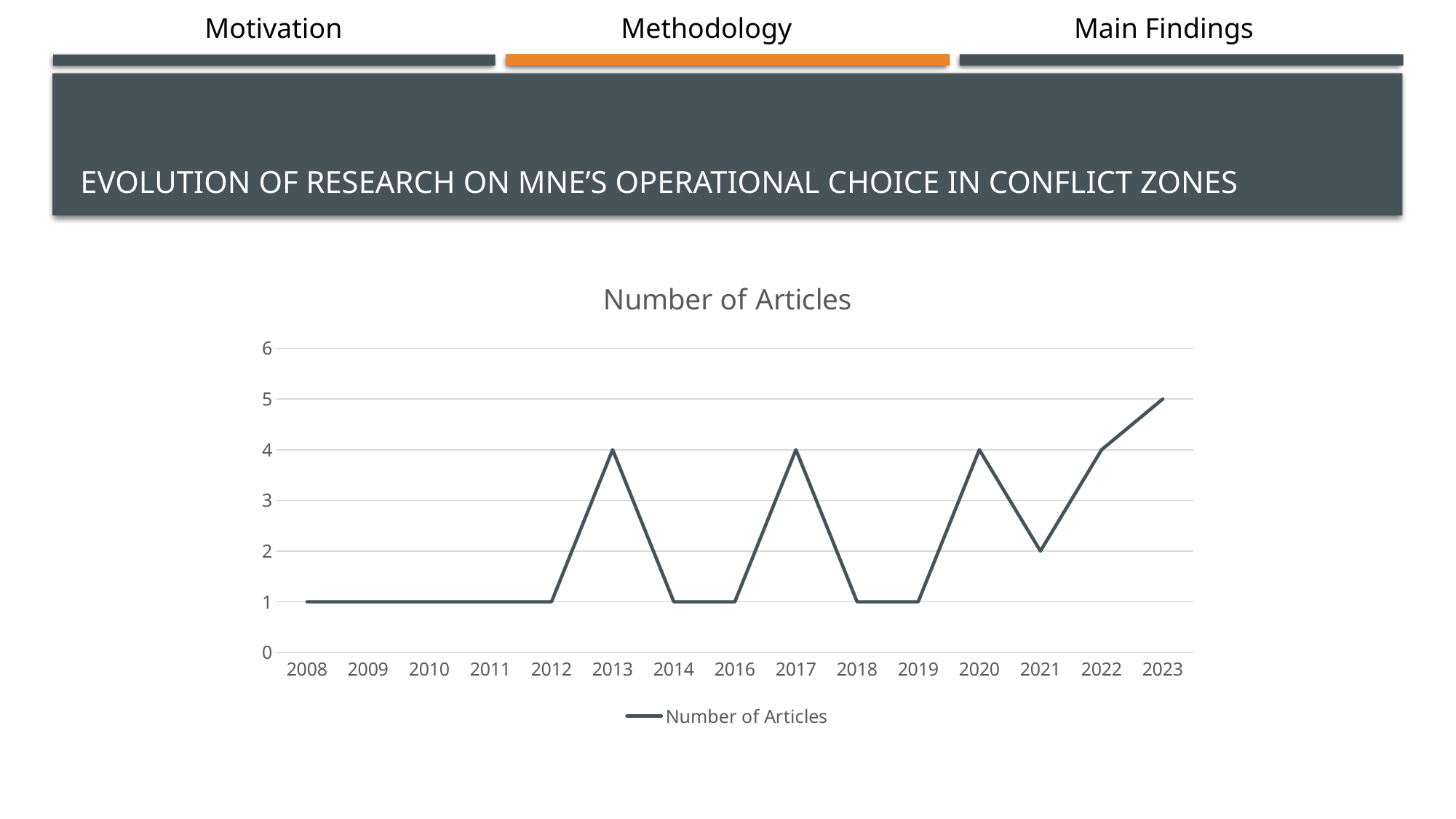
What type of chart is shown on the slide? line chart What is the number of articles in 2008? 1 Does the number of articles rise or fall from 2021 to 2023? rise What is the number of articles in 2013? 4 How many series does the legend list? 1 What is the difference in the number of articles between 2023 and 2021? 3 How many years are shown on the x axis? 15 What is the number of articles in 2023? 5 Which year has the highest number of articles? 2023 Which year has more articles, 2017 or 2018? 2017 What is the title of the chart? Number of Articles What is the number of articles in 2021? 2